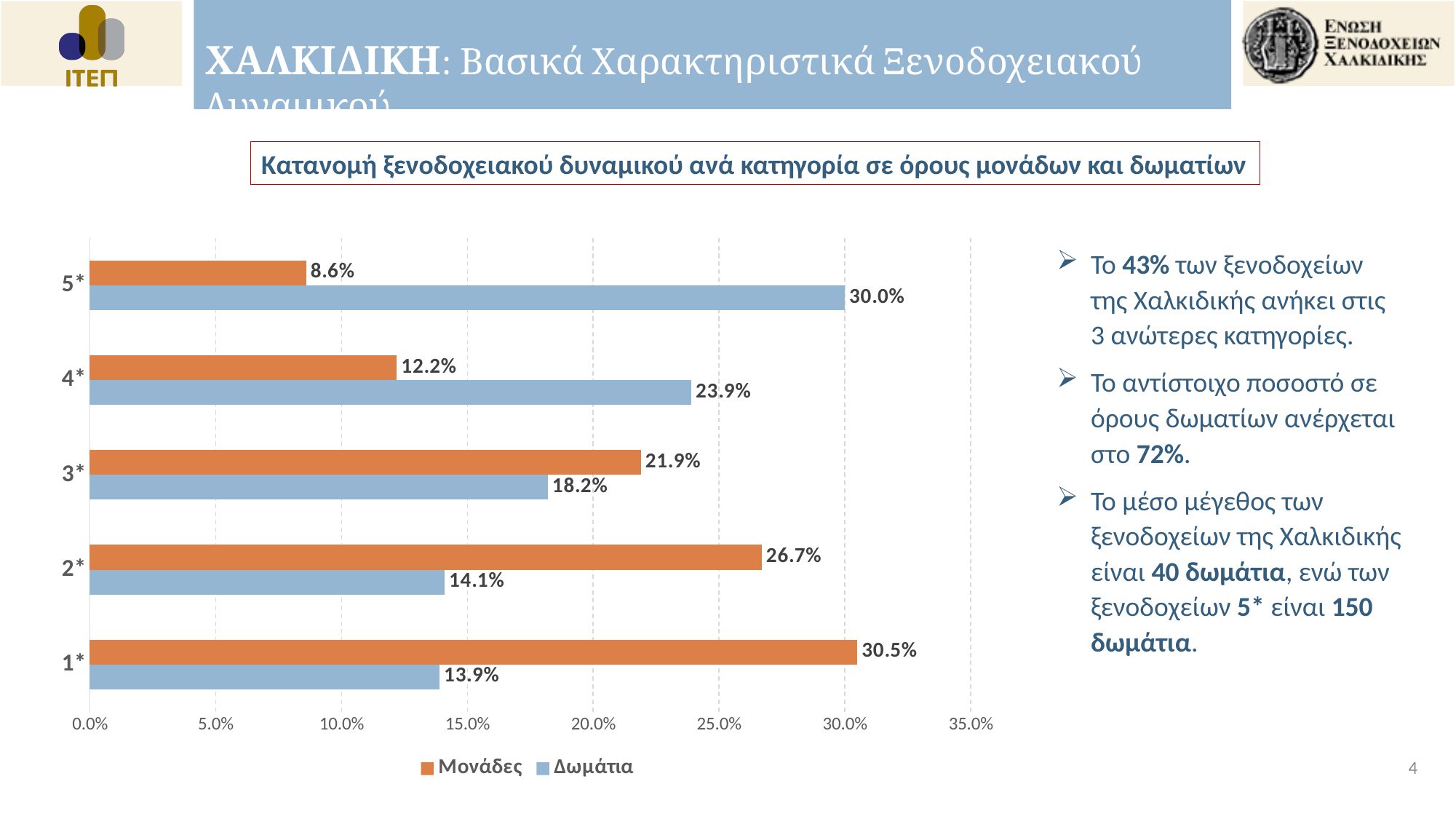
Which category has the lowest Μονάδες value? 5* What kind of chart is shown on the slide? bar chart Is the Δωμάτια value for 3* greater or less than 20.0%? less How many series does the legend list? 2 Which colour represents the Δωμάτια series? blue What is the Δωμάτια value for the 4* category? 23.9% What is the difference between the Δωμάτια and Μονάδες values for the 5* category? 21.4% What is the Μονάδες value for the 5* category? 8.6% What is the Μονάδες value for the 1* category? 30.5% Which category has the highest Δωμάτια value? 5* How many categories are shown on the chart? 5 For the 2* category, which series has the larger value, Μονάδες or Δωμάτια? Μονάδες